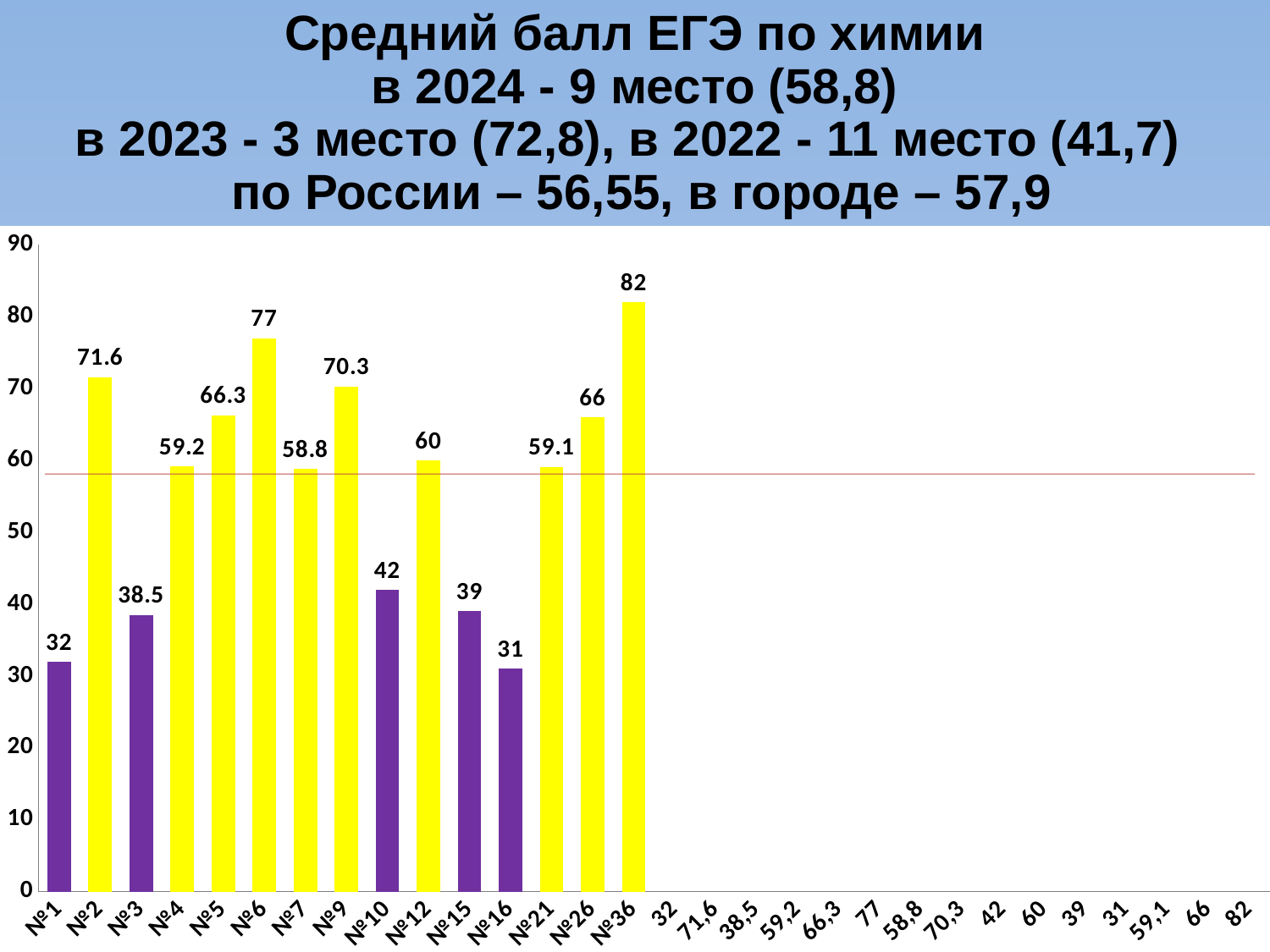
What is the difference between the values for №36 and №1? 50 Which category has the highest value? №36 Is the value for №10 greater or less than 50? less Which category has the lowest value? №16 What is the value for №6? 77 What kind of chart is shown on the slide? bar chart What is the difference between the values for №6 and №9? 6.7 What is the value for №16? 31 How many bars are plotted in the chart? 15 Which is larger, the value for №5 or the value for №26? №5 How many bars are coloured purple? 5 What is the value for №2? 71.6